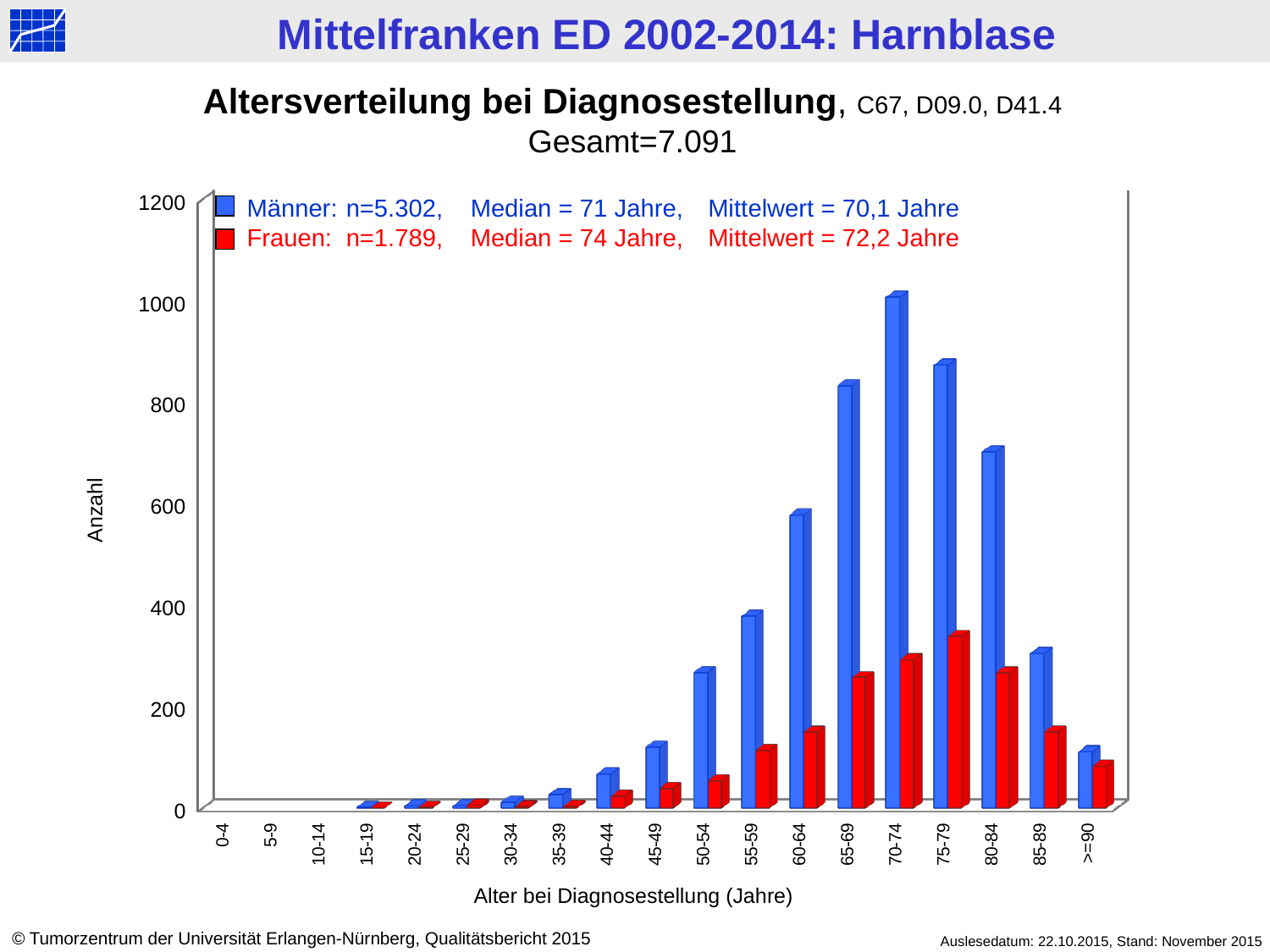
How many series does the legend list? 2 In the 70-74 age group, which series has the larger value, Männer or Frauen? Männer Do the values for Männer rise or fall from the 40-44 age group to the 70-74 age group? rise Is the value for Frauen in the 75-79 age group greater or less than 200? greater Which age group has the highest value for Männer? 70-74 Is the value for Männer in the 65-69 age group greater or less than 800? greater Is the value for Männer in the 80-84 age group greater or less than 800? less What kind of chart is shown on the slide? bar chart According to the legend, what is the median age for Frauen? 74 Jahre Which age group has the highest value for Frauen? 75-79 How many age categories are shown on the x axis? 19